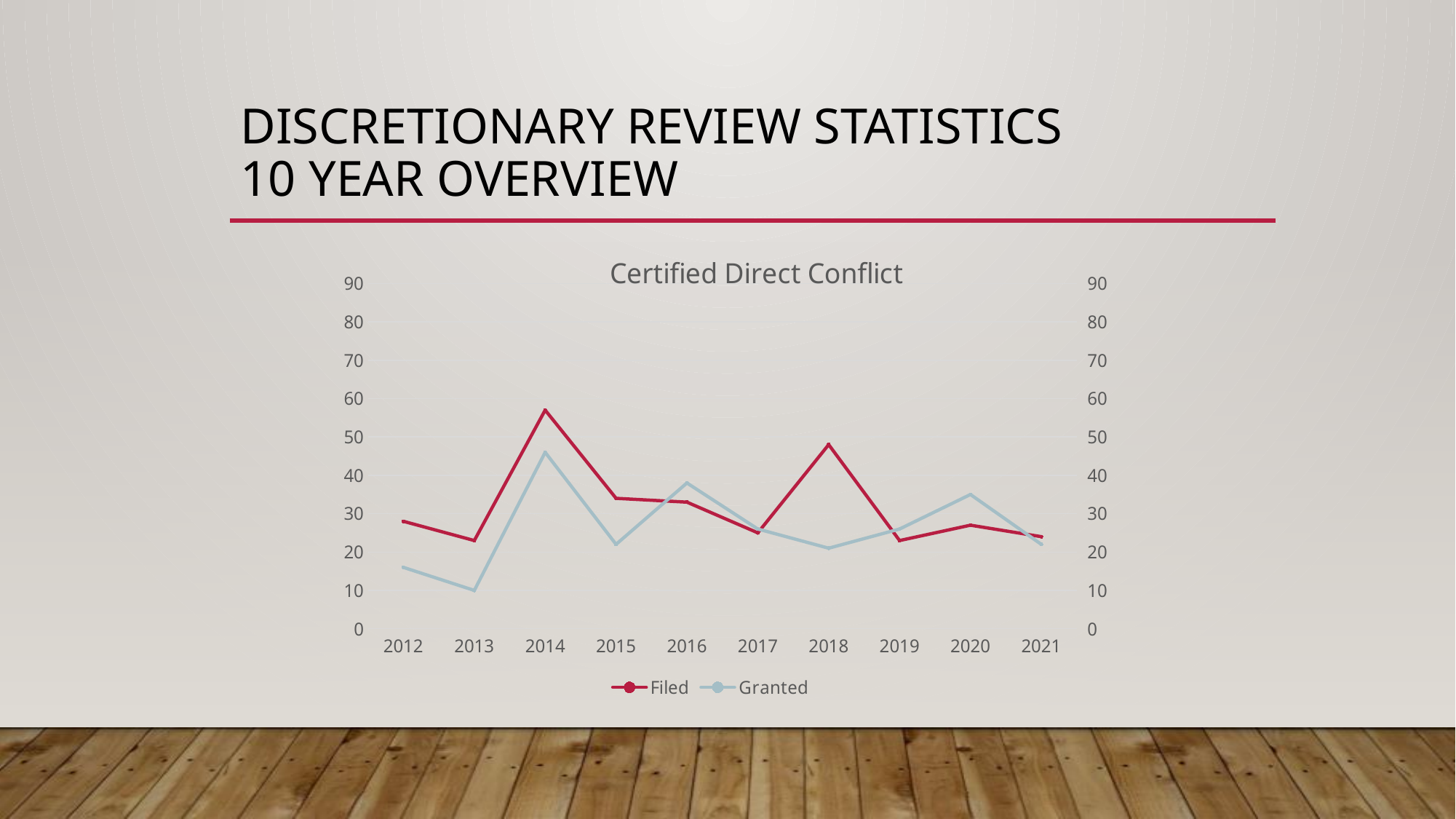
How many series does the legend list? 2 In 2014, which series is larger, Filed or Granted? Filed What kind of chart is shown on the slide? line chart What is the title of the chart? Certified Direct Conflict In which year is the Filed series at its highest? 2014 Is the Filed value for 2014 greater or less than 50? greater In which year is the Granted series at its lowest? 2013 Is the Granted value for 2012 greater or less than 20? less In 2016, which series is larger, Filed or Granted? Granted In which year is the Granted series at its highest? 2014 How many years are plotted along the x axis? 10 Does the Filed series rise or fall from 2013 to 2014? rise